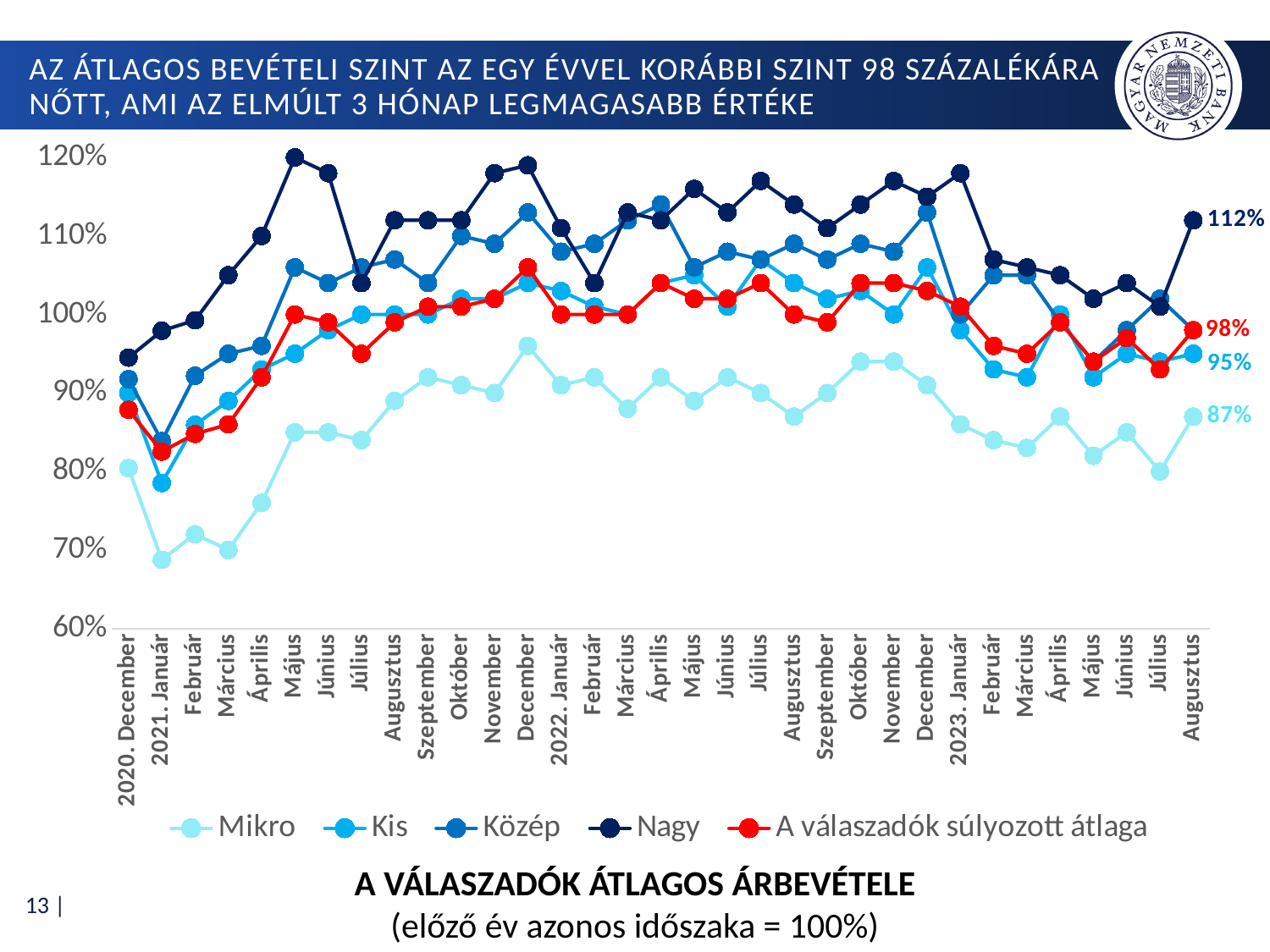
What is the value for A válaszadók súlyozott átlaga in Augusztus 2023? 98% Which series has the lowest value in Augusztus 2023? Mikro What kind of chart is shown on the slide? line chart Which series has the highest value in Augusztus 2023? Nagy Is the value for Nagy in Május 2021 greater or less than 110%? greater What is the value for Nagy in Augusztus 2023? 112% Is the value for Mikro in 2021. Január greater or less than 70%? less What is the difference between the Nagy and Mikro values in Augusztus 2023? 25 percentage points How many series does the legend list? 5 How many months (points) are plotted along the x axis? 33 What is the title of the chart? A VÁLASZADÓK ÁTLAGOS ÁRBEVÉTELE (előző év azonos időszaka = 100%) What is the value for Mikro in Augusztus 2023? 87%